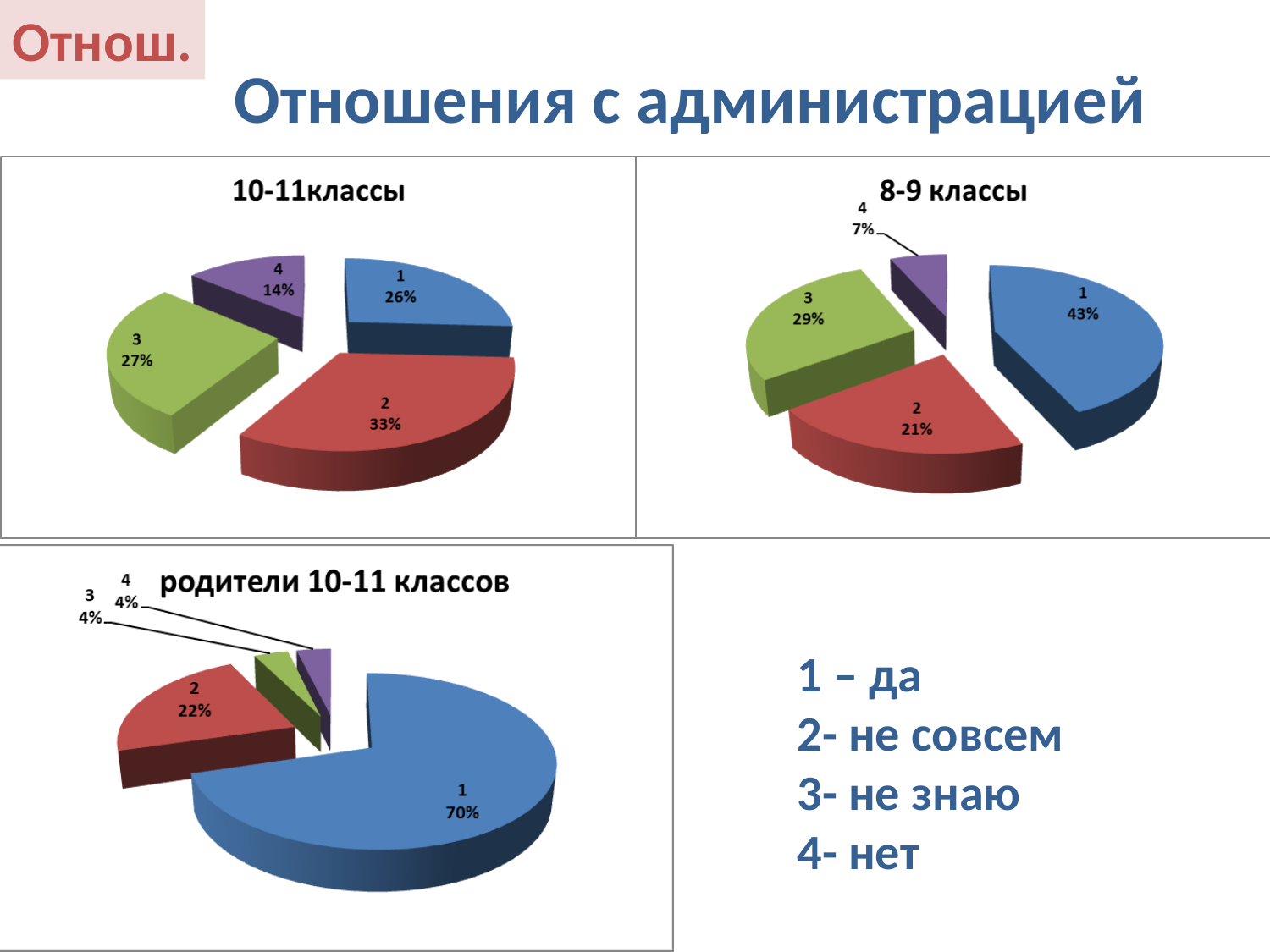
How many slices does the "8-9 классы" chart have? 4 What type of chart is the "10-11классы" chart? Pie chart How many charts are shown on the slide? 3 In the "8-9 классы" chart, what share does category 1 have? 43% In the "10-11классы" chart, which category has the smallest share? 4 In the "родители 10-11 классов" chart, what is the difference between the shares of category 1 and category 2? 48% In the "8-9 классы" chart, which category has the largest share? 1 In the "10-11классы" chart, what share does category 2 have? 33% In the "10-11классы" chart, what is the difference between the shares of category 2 and category 4? 19% In the "родители 10-11 классов" chart, what share does category 1 have? 70% In the "8-9 классы" chart, which is larger: the share of category 2 or category 3? 3 In the "родители 10-11 классов" chart, what share does category 3 have? 4%